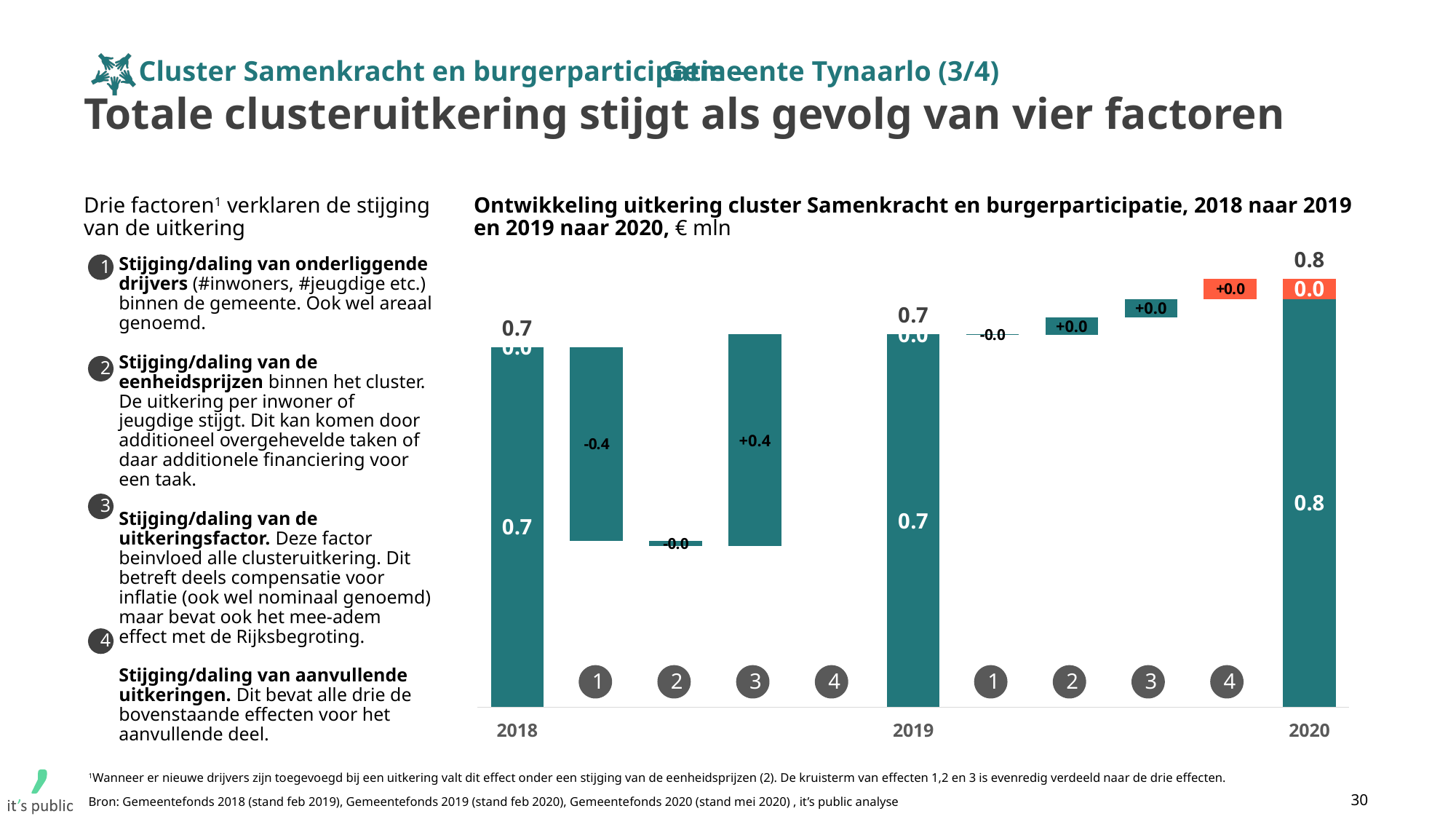
What is the value of factor 1 in the step from 2018 to 2019? -0.4 What is the value of factor 3 in the step from 2018 to 2019? +0.4 Is the total for 2020 larger or smaller than the total for 2019? larger What is the value of factor 2 in the step from 2018 to 2019? -0.0 Does the total cluster payment rise or fall from 2018 to 2020? rise How many year totals are shown in the chart? 3 Which year has the highest total cluster payment? 2020 What is the value of factor 4 in the step from 2019 to 2020? +0.0 What is the difference between the total for 2020 and the total for 2018? 0.1 What is the total cluster payment shown for 2018? 0.7 What is the total cluster payment shown for 2020? 0.8 What unit is stated in the chart title? € mln